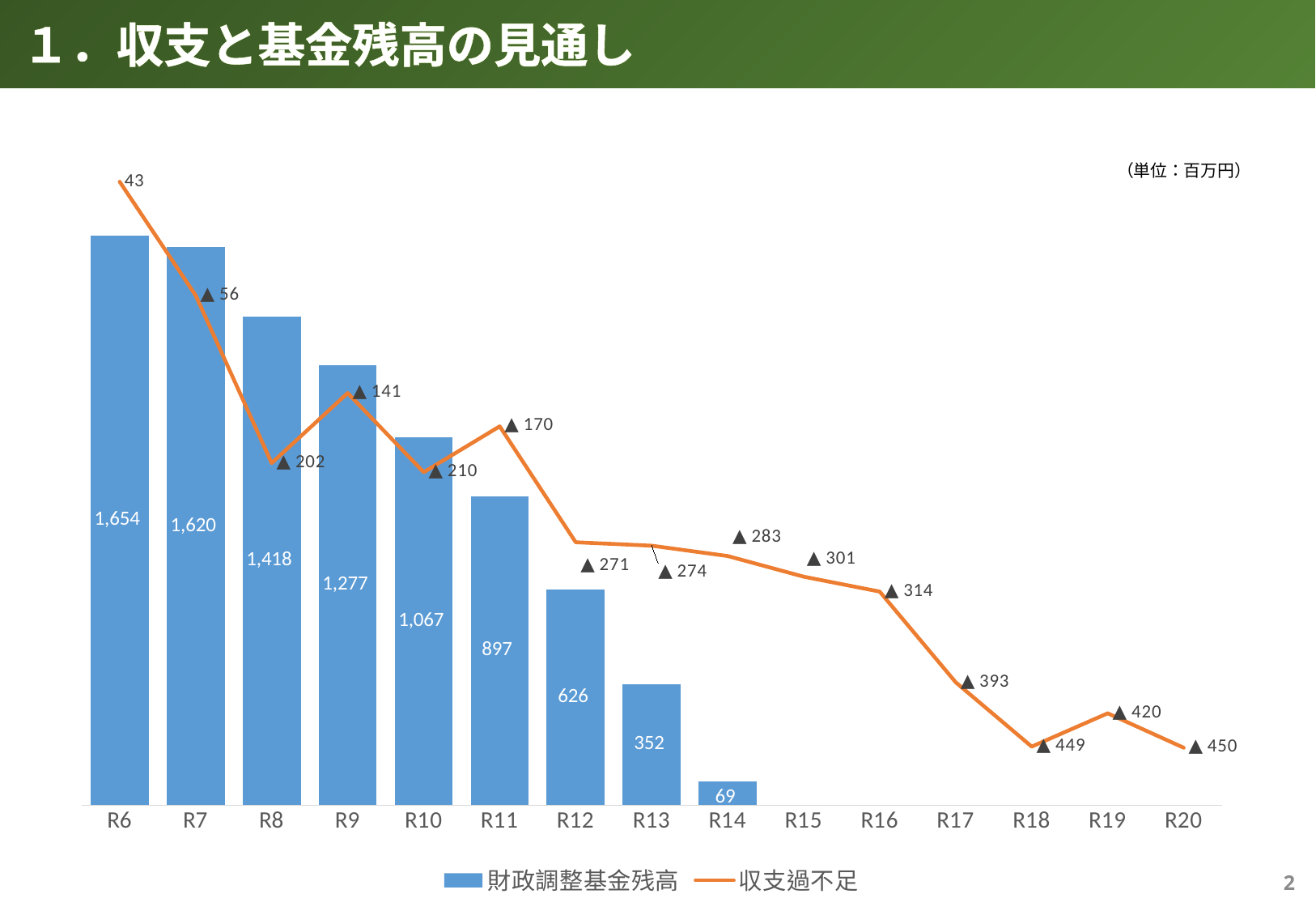
Which year has the highest 財政調整基金残高? R6 What is the value of 収支過不足 for R6? 43 How many series does the legend list? 2 Which year has the lowest 財政調整基金残高 among the plotted bars? R14 What kind of chart is this? Combined bar and line chart What is the difference between the 財政調整基金残高 for R6 and R7? 34 How many years are shown on the x axis? 15 Do the 財政調整基金残高 bars rise or fall from R6 to R14? Fall What is the value of 財政調整基金残高 for R10? 1,067 What is the value of 収支過不足 for R17? ▲393 How many bars are plotted for 財政調整基金残高? 9 Which is larger, the 財政調整基金残高 for R8 or for R9? R8